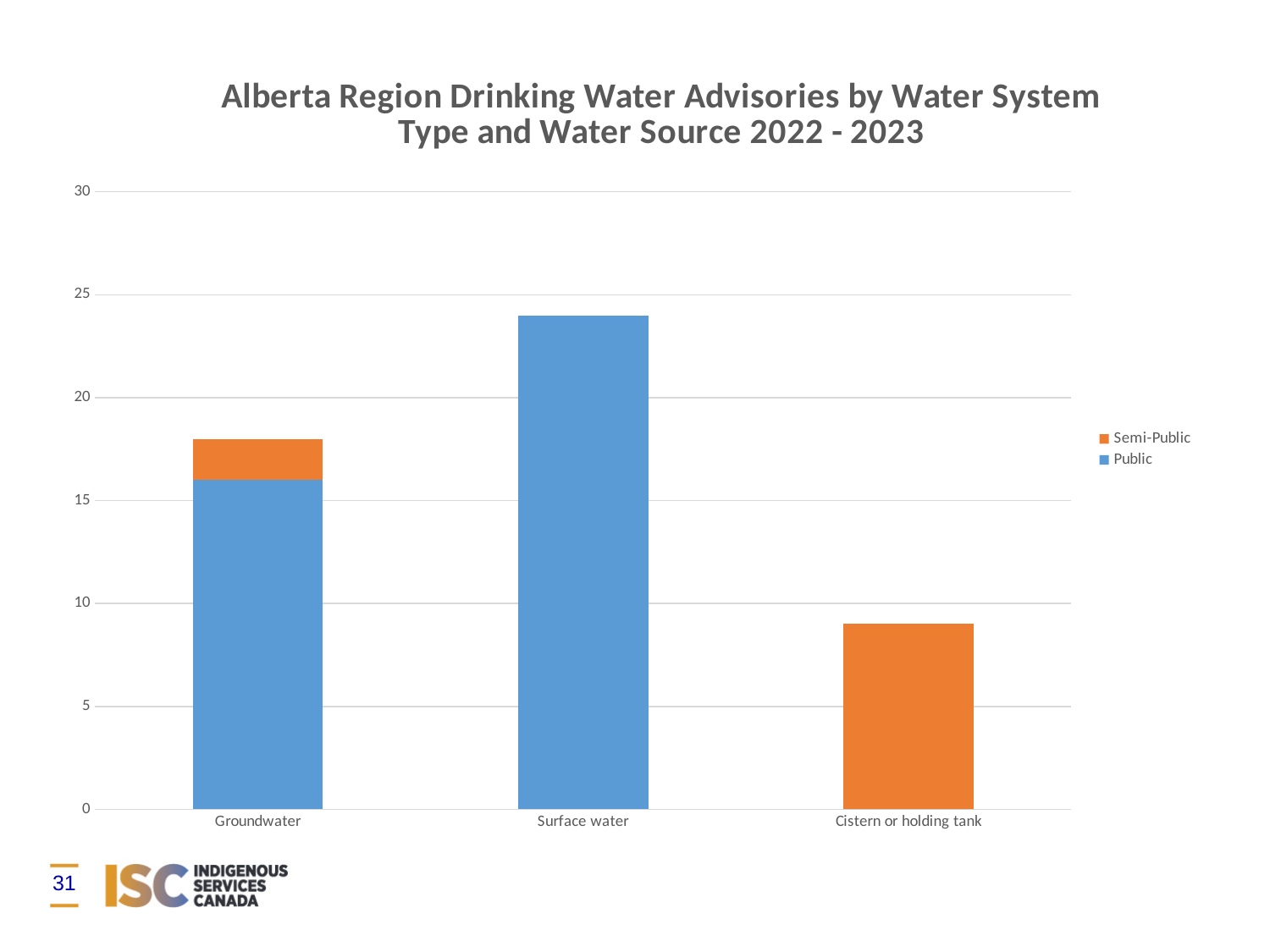
Is the value for Cistern or holding tank greater or less than 5? greater Is the Public value for Groundwater greater or less than 10? greater How many water source categories are shown on the x axis? 3 Is the total value for Groundwater greater or less than 15? greater What type of chart is shown on the slide? Bar chart Which water source category has the shortest bar? Cistern or holding tank Which water source category has the tallest bar? Surface water Which series is shown in orange in the legend? Semi-Public Which has a taller total bar, Groundwater or Cistern or holding tank? Groundwater Which category's bar consists only of the Semi-Public series? Cistern or holding tank How many series does the legend list? 2